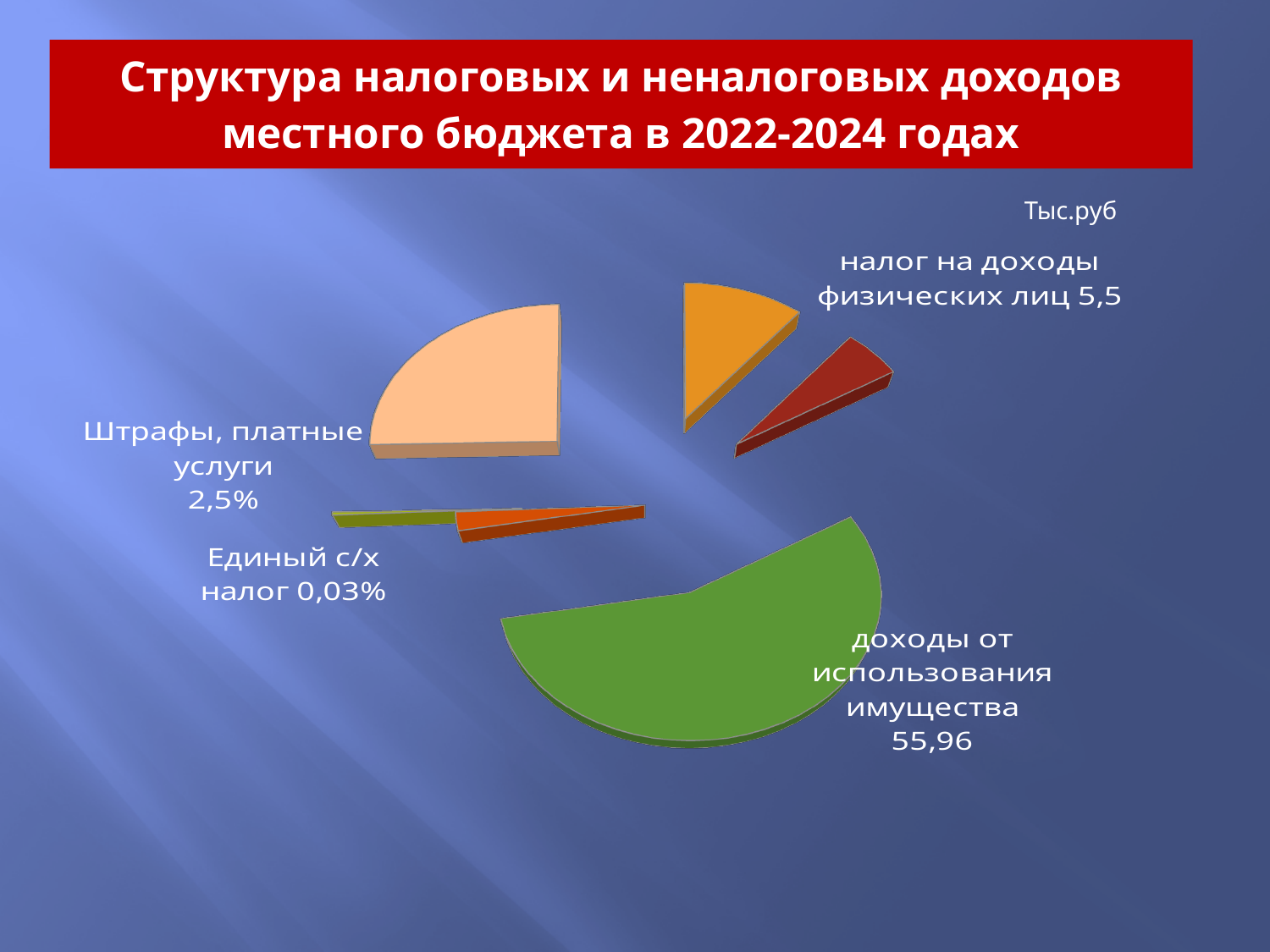
What value is shown for "доходы от использования имущества"? 55,96 What kind of chart is shown on the slide? pie chart What value is shown for "налог на доходы физических лиц"? 5,5 How many slices does the pie chart have? 6 What is the difference between the values for "Штрафы, платные услуги" and "Единый с/х налог"? 2,47% What unit is indicated in the top right of the chart area? Тыс.руб Which is larger: the value for "Штрафы, платные услуги" or for "Единый с/х налог"? Штрафы, платные услуги What value is shown for "Единый с/х налог"? 0,03% Which category has the largest slice of the pie? доходы от использования имущества What value is shown for "Штрафы, платные услуги"? 2,5% What is the title of the slide? Структура налоговых и неналоговых доходов местного бюджета в 2022-2024 годах